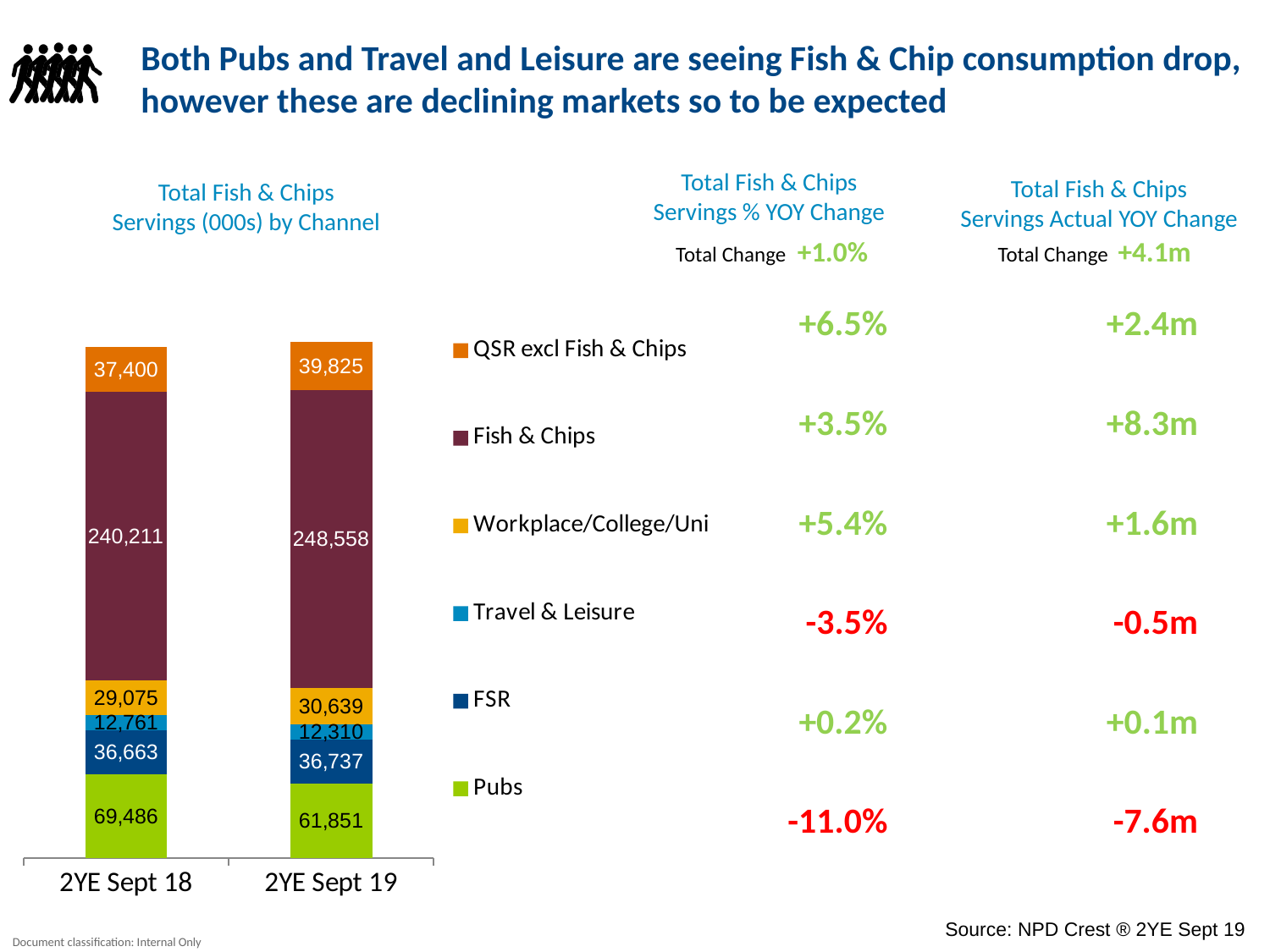
Which channel has the largest segment in the 2YE Sept 18 bar? Fish & Chips What is the value for Pubs in 2YE Sept 18? 69,486 How many bars (time periods) are shown on the x axis of the chart? 2 By how much did the Pubs value fall from 2YE Sept 18 to 2YE Sept 19? 7,635 Which is larger: the QSR excl Fish & Chips value in 2YE Sept 18 or in 2YE Sept 19? 2YE Sept 19 What is the value for Travel & Leisure in 2YE Sept 19? 12,310 Which channel has the smallest segment in the 2YE Sept 19 bar? Travel & Leisure Does the Fish & Chips value rise or fall from 2YE Sept 18 to 2YE Sept 19? rise How many series does the chart legend list? 6 What is the value for Fish & Chips in 2YE Sept 19? 248,558 What kind of chart is shown on the left of the slide? stacked bar chart What is the total of the 2YE Sept 19 stacked bar? 429,920